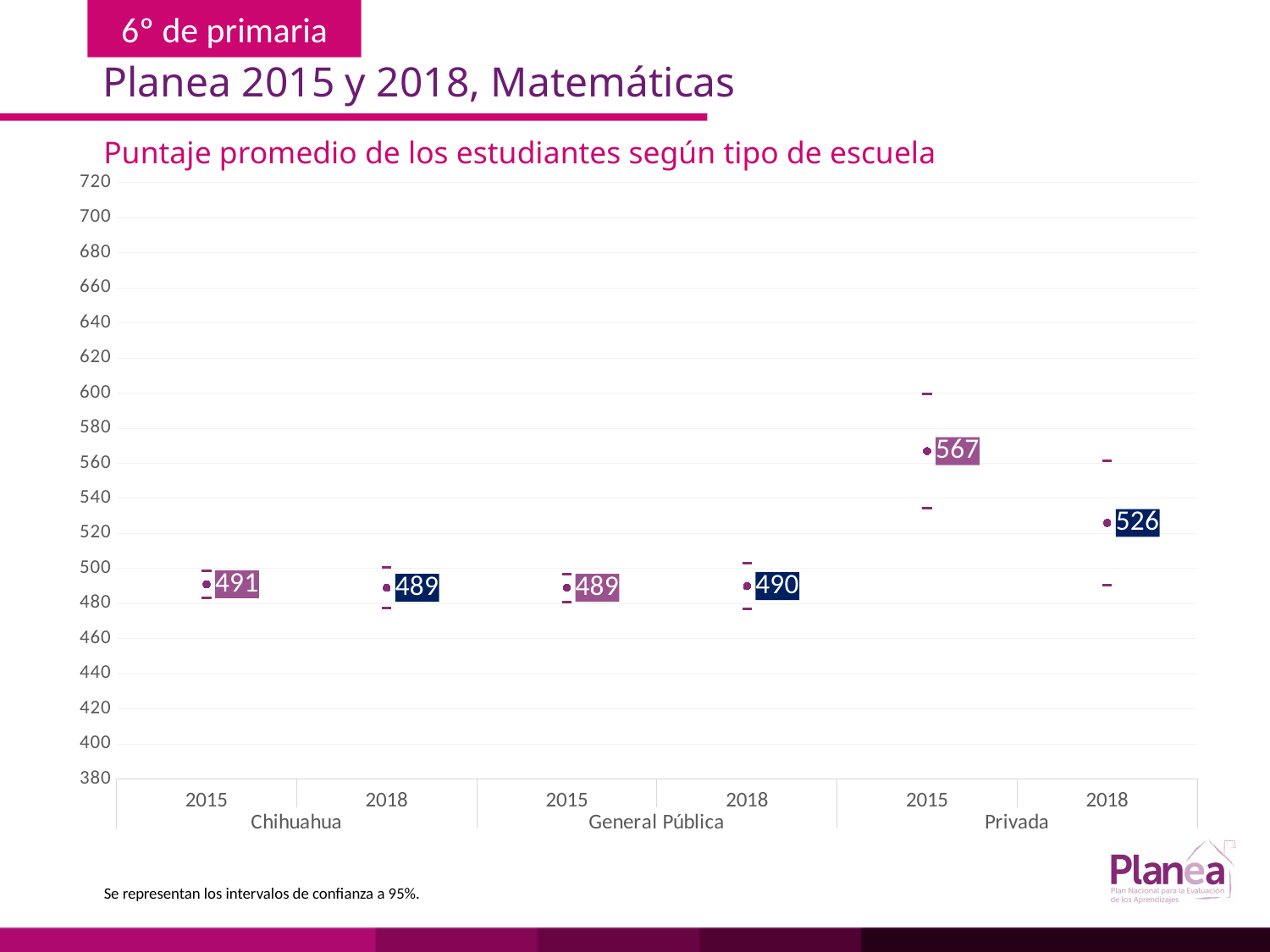
What is the average score for Privada schools in 2015? 567 What is the difference between the Privada 2015 score and the Chihuahua 2015 score? 76 What is the average score for Privada schools in 2018? 526 Which category and year has the highest average score? Privada 2015 What is the average score for Chihuahua in 2015? 491 Which is larger, the Chihuahua 2015 score or the General Pública 2015 score? Chihuahua 2015 By how many points did the Privada average score change from 2015 to 2018? 41 Did the Privada average score rise or fall from 2015 to 2018? fall What is the title of the chart? Puntaje promedio de los estudiantes según tipo de escuela Is the value for Privada 2018 greater or less than 500? greater What is the average score for General Pública schools in 2018? 490